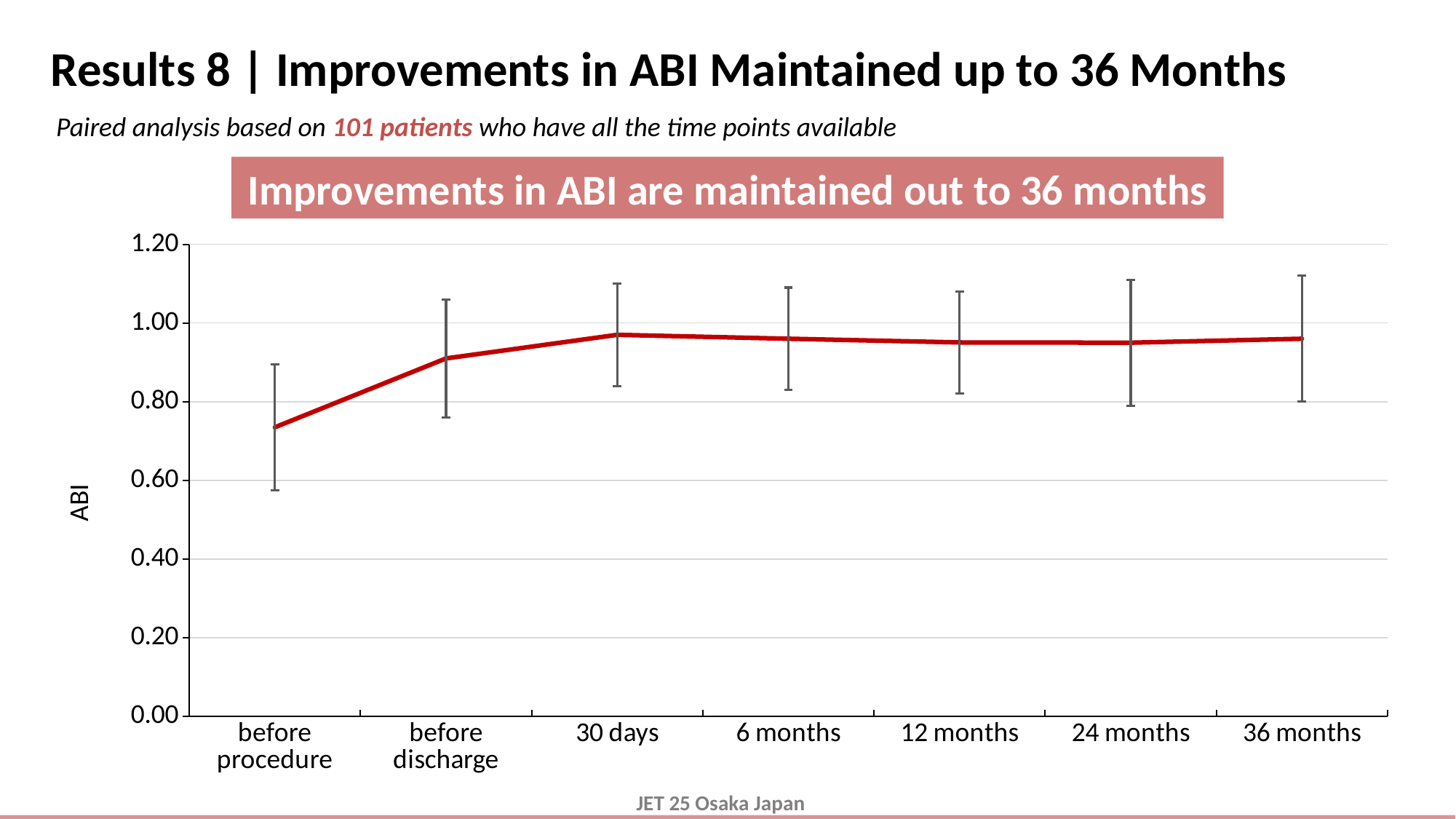
Is the ABI value at 30 days greater or less than 1.00? less What does the highlighted banner above the chart say? Improvements in ABI are maintained out to 36 months Which time point has the lowest ABI value? before procedure Is the ABI value at 36 months greater or less than 0.80? greater What kind of chart is shown on the slide? line chart Does the ABI value rise or fall from before procedure to 30 days? rise Is the ABI value before procedure greater or less than 0.80? less Which is larger, the ABI value before procedure or before discharge? before discharge Which is larger, the ABI value before procedure or at 36 months? 36 months What is the label on the y axis of the chart? ABI How many time points are plotted along the x axis? 7